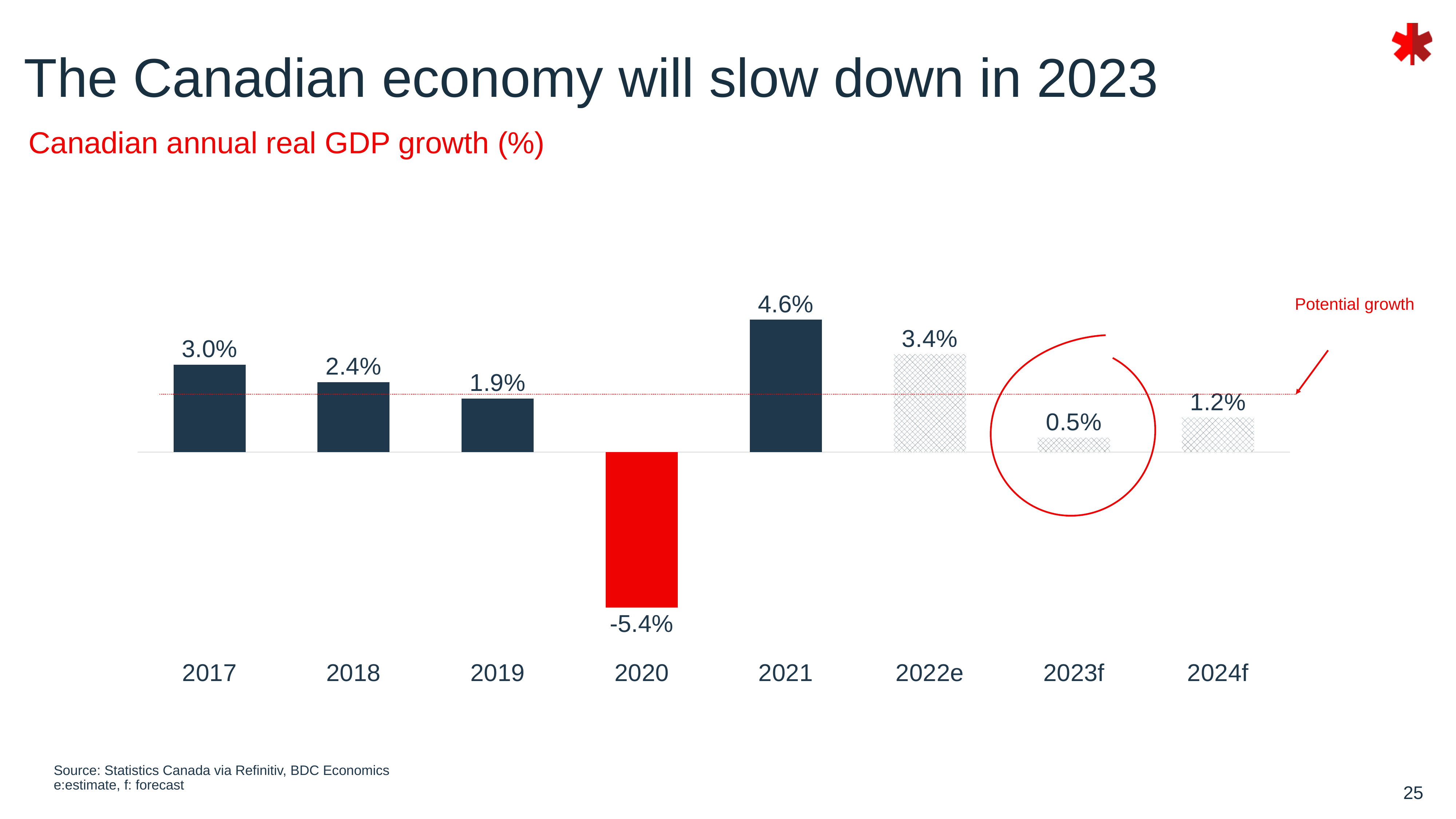
What is the forecast GDP growth value shown for 2023f? 0.5% Do the GDP growth values rise or fall from 2017 to 2019? Fall What is the Canadian annual real GDP growth value shown for 2021? 4.6% What does the red dotted horizontal line across the chart represent? Potential growth What kind of chart is shown on the slide? Bar chart How many years (categories) are shown on the x axis of the chart? 8 Which year has the highest GDP growth value in the chart? 2021 Which year has the lowest GDP growth value in the chart? 2020 What is the difference between the GDP growth values for 2022e and 2023f? 2.9% What is the GDP growth value shown for 2022e? 3.4% Which is larger, the GDP growth value for 2017 or for 2018? 2017 What is the GDP growth value shown for 2020? -5.4%